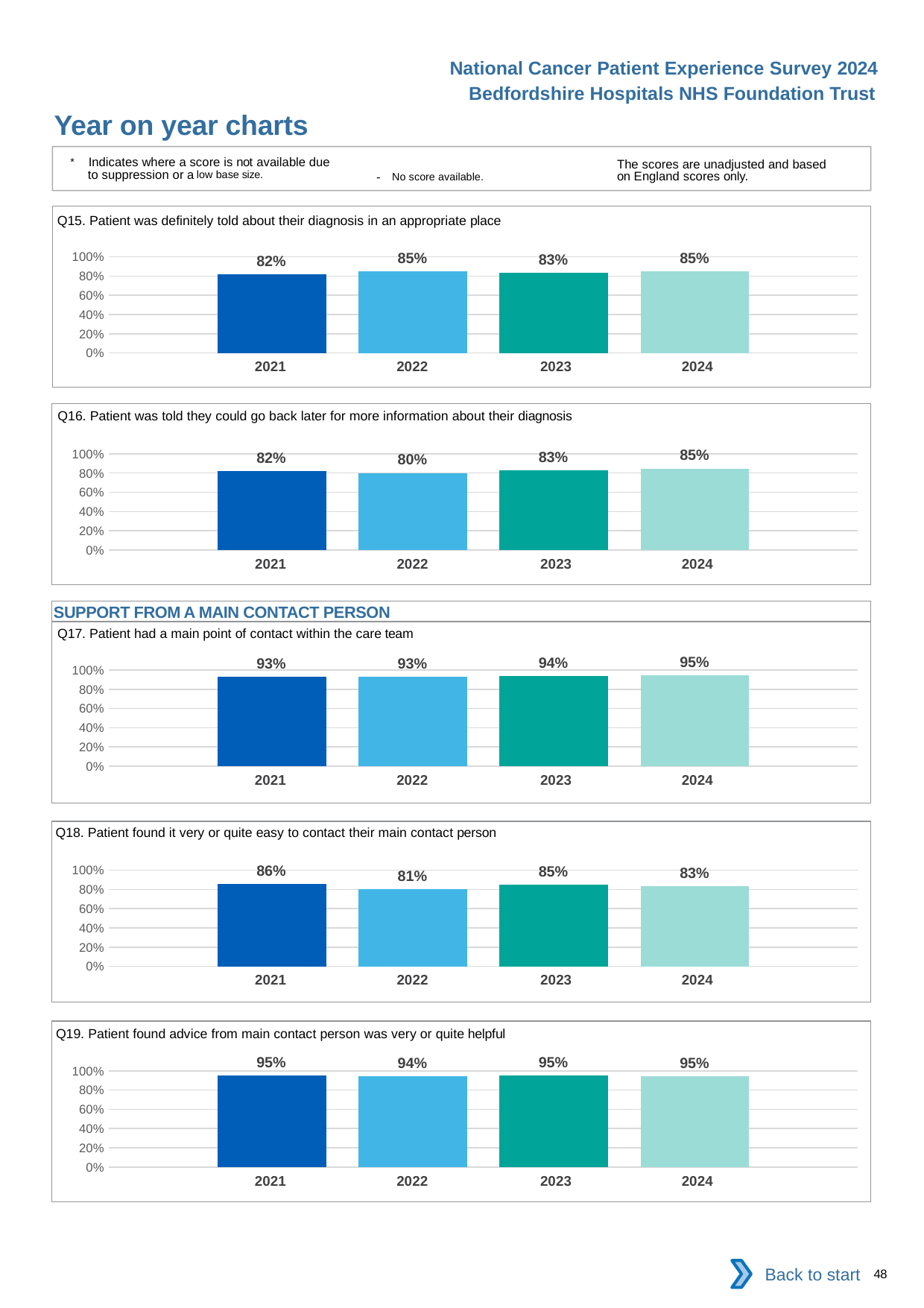
In the Q16 chart (Patient was told they could go back later for more information about their diagnosis), what is the difference between the 2024 and 2021 values? 3 percentage points What kind of chart is the Q15 chart (Patient was definitely told about their diagnosis in an appropriate place)? bar chart In the Q15 chart (Patient was definitely told about their diagnosis in an appropriate place), is the value for 2021 greater or less than 60%? greater How many years are shown in the Q19 chart (Patient found advice from main contact person was very or quite helpful)? 4 In the Q18 chart (Patient found it very or quite easy to contact their main contact person), which is larger, the value for 2023 or the value for 2024? 2023 In the Q15 chart (Patient was definitely told about their diagnosis in an appropriate place), what is the value for 2022? 85% In the Q16 chart (Patient was told they could go back later for more information about their diagnosis), which year has the lowest value? 2022 In the Q17 chart (Patient had a main point of contact within the care team), do the values rise or fall from 2021 to 2024? rise In the Q18 chart (Patient found it very or quite easy to contact their main contact person), which year has the highest value? 2021 In the Q19 chart (Patient found advice from main contact person was very or quite helpful), what is the value for 2022? 94% In the Q18 chart (Patient found it very or quite easy to contact their main contact person), what is the difference between the 2021 and 2022 values? 5 percentage points In the Q17 chart (Patient had a main point of contact within the care team), what is the value for 2024? 95%